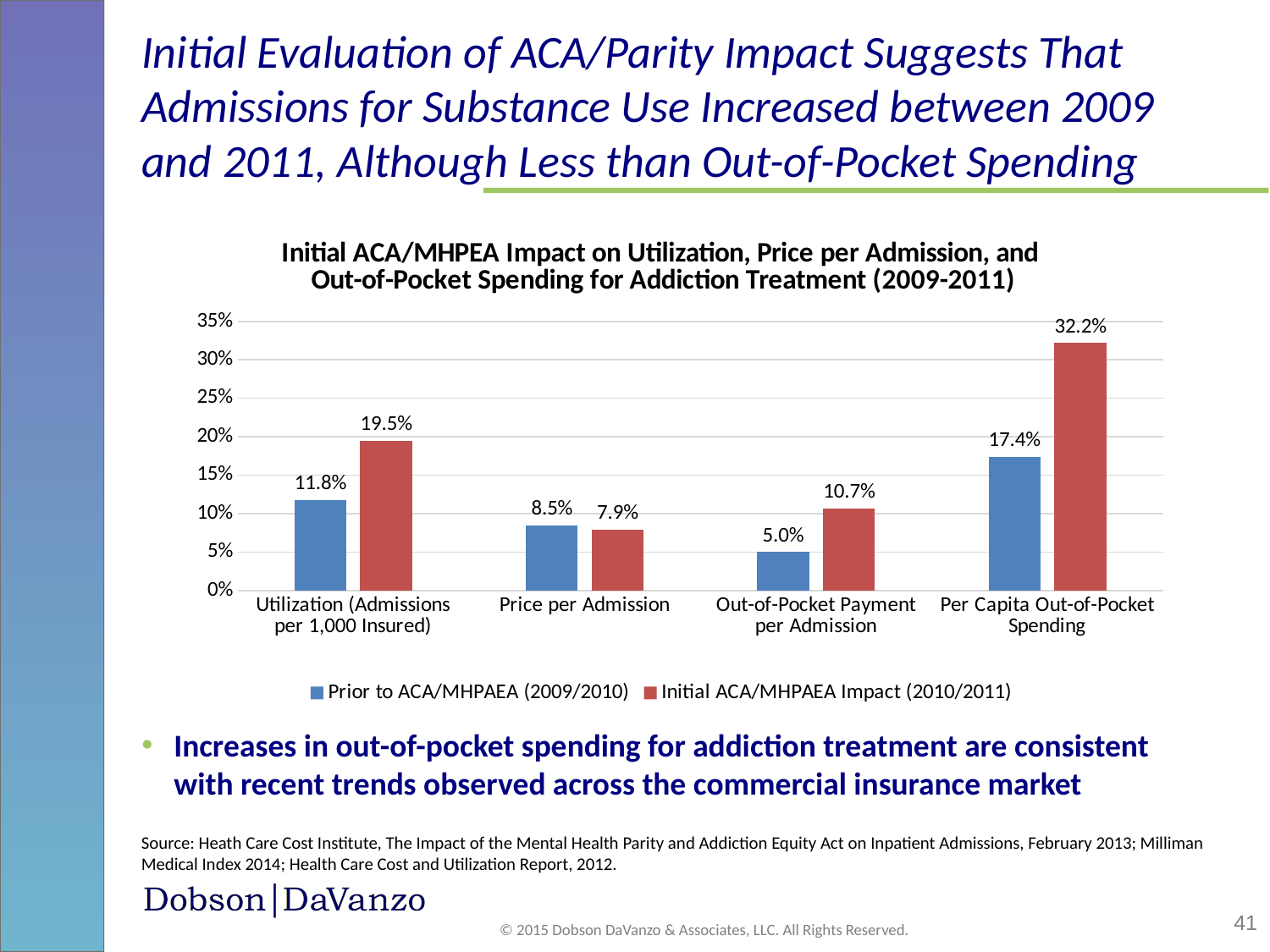
What is the difference between the Initial ACA/MHPAEA Impact (2010/2011) and Prior to ACA/MHPAEA (2009/2010) values for Per Capita Out-of-Pocket Spending? 14.8% Which category has the highest value in the Initial ACA/MHPAEA Impact (2010/2011) series? Per Capita Out-of-Pocket Spending Is the Initial ACA/MHPAEA Impact (2010/2011) value for Utilization (Admissions per 1,000 Insured) greater or less than 15%? greater What is the value for Out-of-Pocket Payment per Admission in the Prior to ACA/MHPAEA (2009/2010) series? 5.0% What kind of chart is shown on the slide? bar chart Which category has the lowest value in the Prior to ACA/MHPAEA (2009/2010) series? Out-of-Pocket Payment per Admission How many series does the legend list? 2 What colour are the bars for the Initial ACA/MHPAEA Impact (2010/2011) series? red What is the value for Utilization (Admissions per 1,000 Insured) in the Prior to ACA/MHPAEA (2009/2010) series? 11.8% What is the value for Per Capita Out-of-Pocket Spending in the Initial ACA/MHPAEA Impact (2010/2011) series? 32.2% For Price per Admission, which series has the larger value: Prior to ACA/MHPAEA (2009/2010) or Initial ACA/MHPAEA Impact (2010/2011)? Prior to ACA/MHPAEA (2009/2010) How many categories are shown on the x axis of the chart? 4